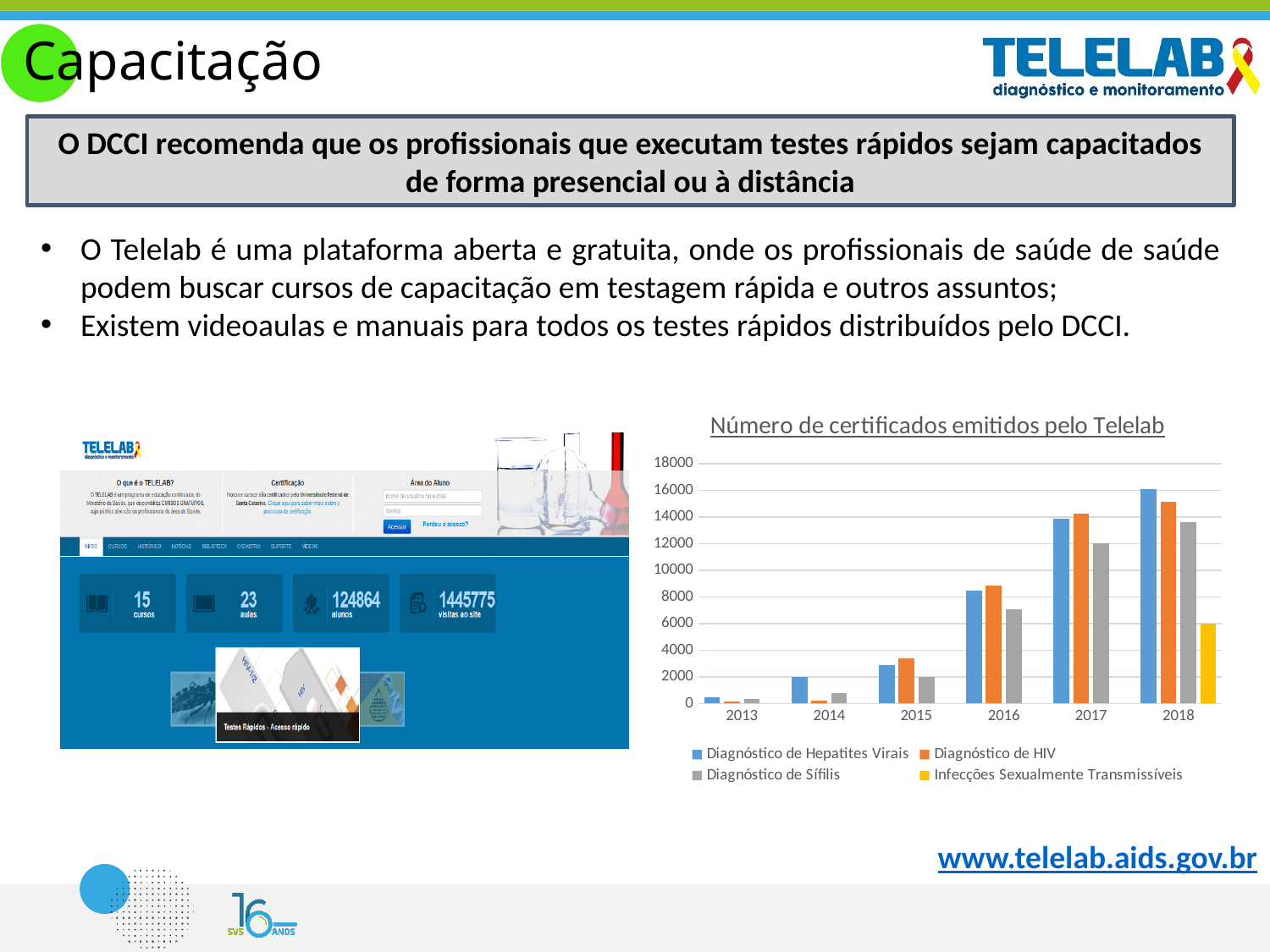
In 2018, which is larger: Diagnóstico de Hepatites Virais or Diagnóstico de Sífilis? Diagnóstico de Hepatites Virais How many years are shown on the x axis of the chart? 6 Is the value for Diagnóstico de Sífilis in 2016 greater or less than 8000? less Do the values for Diagnóstico de Hepatites Virais rise or fall from 2013 to 2018? rise Which series is shown in yellow in the chart? Infecções Sexualmente Transmissíveis What is the title of the chart on the slide? Número de certificados emitidos pelo Telelab What type of chart is shown on the slide? bar chart In which year is the value for Diagnóstico de HIV lowest? 2013 In which year is the value for Diagnóstico de Hepatites Virais highest? 2018 In 2017, which is larger: Diagnóstico de HIV or Diagnóstico de Sífilis? Diagnóstico de HIV Is the value for Diagnóstico de Hepatites Virais in 2018 greater or less than 14000? greater How many series does the chart legend list? 4